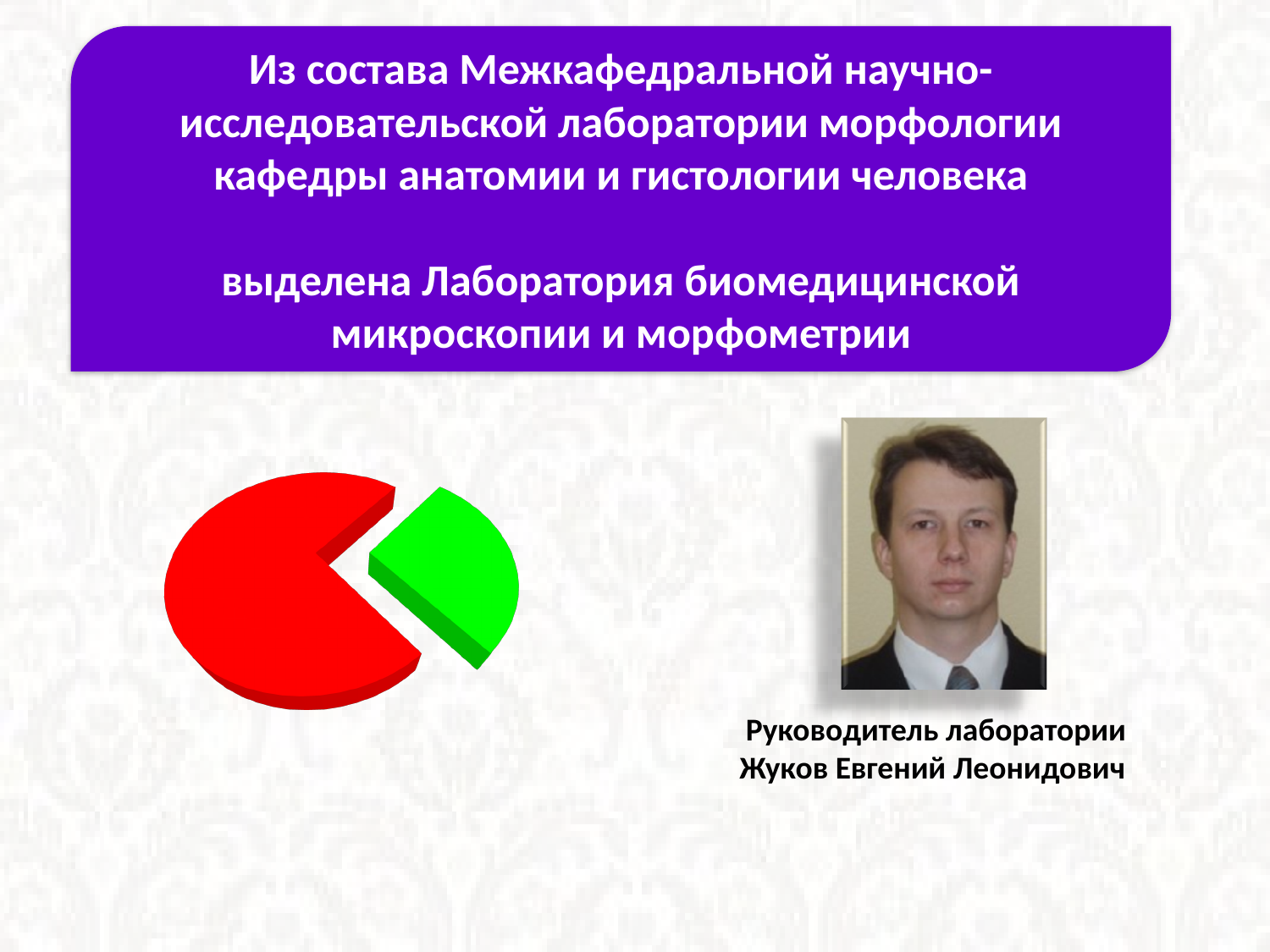
Which slice of the pie chart is the largest? the red slice Which slice of the pie chart is larger, the red one or the green one? the red one Which slice of the pie chart is the smallest? the green slice What kind of chart is shown on the slide? pie chart How many slices does the pie chart have? 2 Which slice of the pie chart is pulled out (exploded) from the rest of the pie? the green slice Does the red slice take up more or less than half of the pie chart? more What two colours are used for the slices of the pie chart? red and green